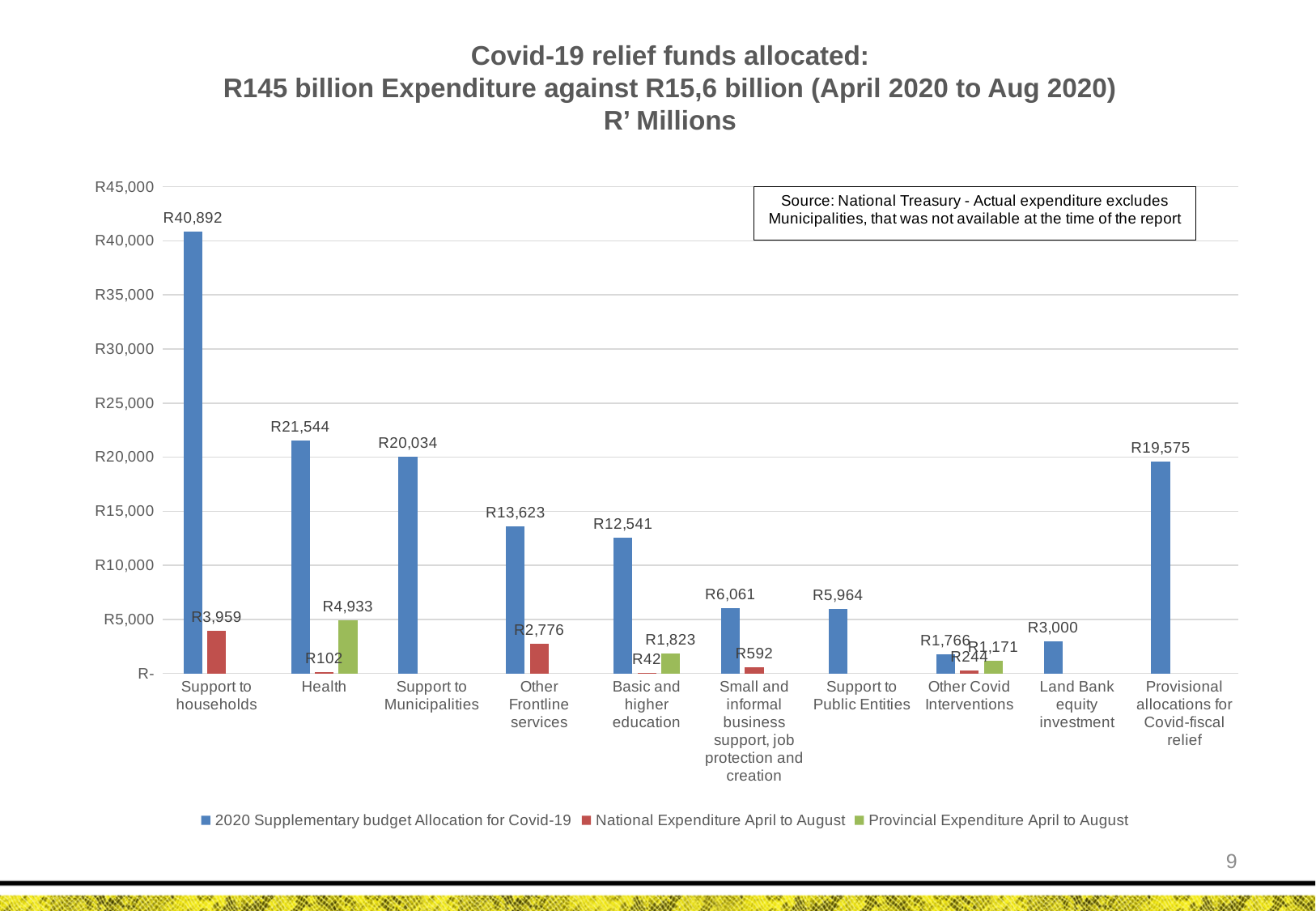
Which category has the lowest 2020 Supplementary budget Allocation for Covid-19? Other Covid Interventions What kind of chart is shown on the slide? bar chart What is the National Expenditure April to August for Other Frontline services? R2,776 Is the 2020 Supplementary budget Allocation for Support to households greater or less than R40,000? greater Which category has the highest 2020 Supplementary budget Allocation for Covid-19? Support to households What is the difference between the 2020 Supplementary budget Allocation for Health and for Support to Municipalities? R1,510 Which has the larger 2020 Supplementary budget Allocation: Support to Municipalities or Provisional allocations for Covid-fiscal relief? Support to Municipalities What is the difference between the 2020 Supplementary budget Allocation and the National Expenditure April to August for Support to households? R36,933 What is the Provincial Expenditure April to August for Health? R4,933 How many series does the legend list? 3 How many categories are shown on the x axis of the chart? 10 What is the 2020 Supplementary budget Allocation for Covid-19 for Support to households? R40,892